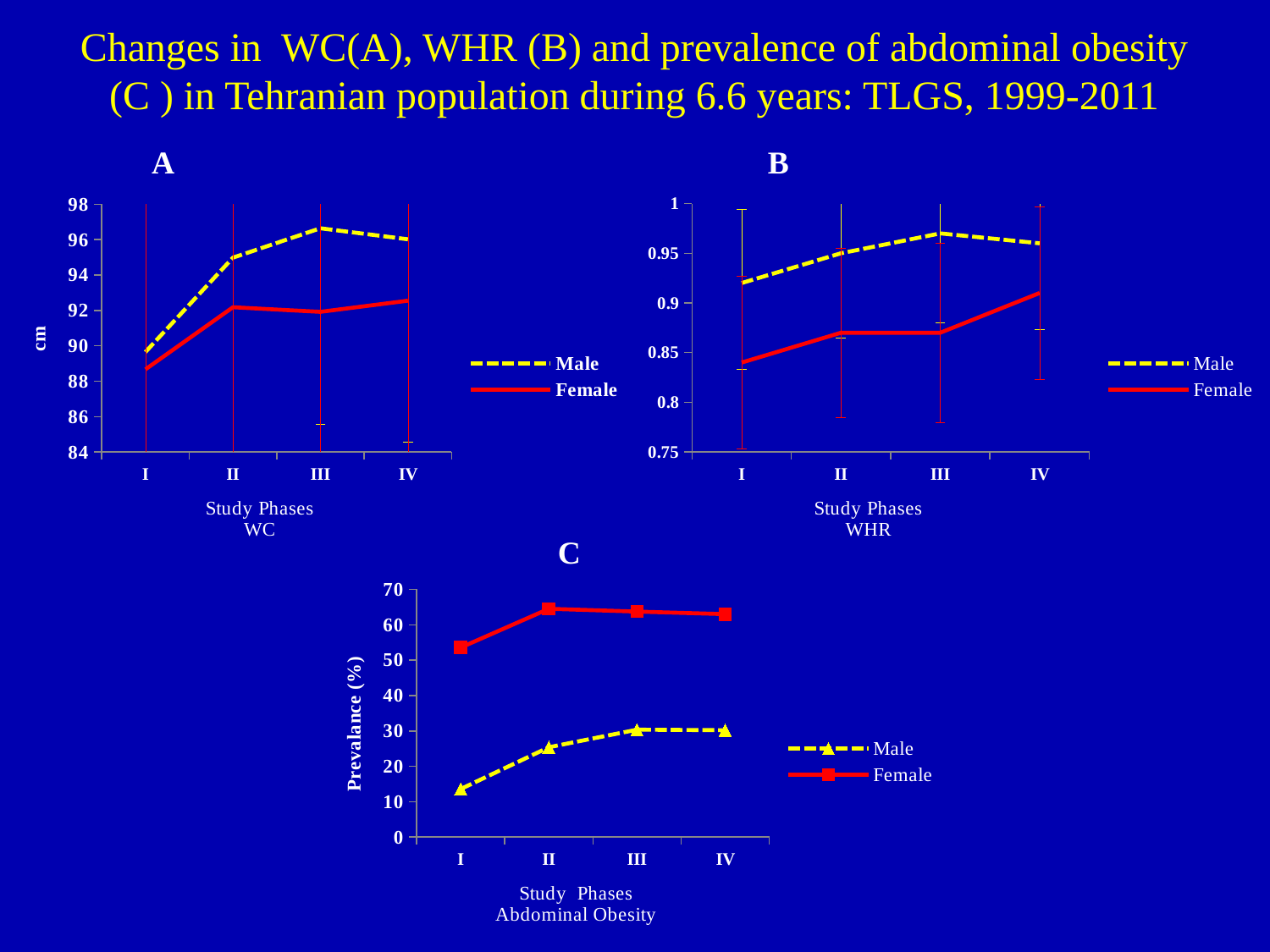
In chart A (WC), how many study phases are shown on the x axis? 4 In chart A (WC), is the Female value at phase I greater or less than 90? less In chart C (Abdominal Obesity), does the Male series rise or fall from phase I to phase III? rise In chart C (Abdominal Obesity), is the Female value at phase I greater or less than 50? greater In chart C (Abdominal Obesity), at which study phase is the Male value lowest? I In chart C (Abdominal Obesity), is the Male value at phase I greater or less than 20? less In chart B (WHR), which series has the larger value at phase IV, Male or Female? Male In chart A (WC), how many series does the legend list? 2 What kind of chart is chart C (Abdominal Obesity)? line chart In chart A (WC), which series has the larger value at phase II, Male or Female? Male